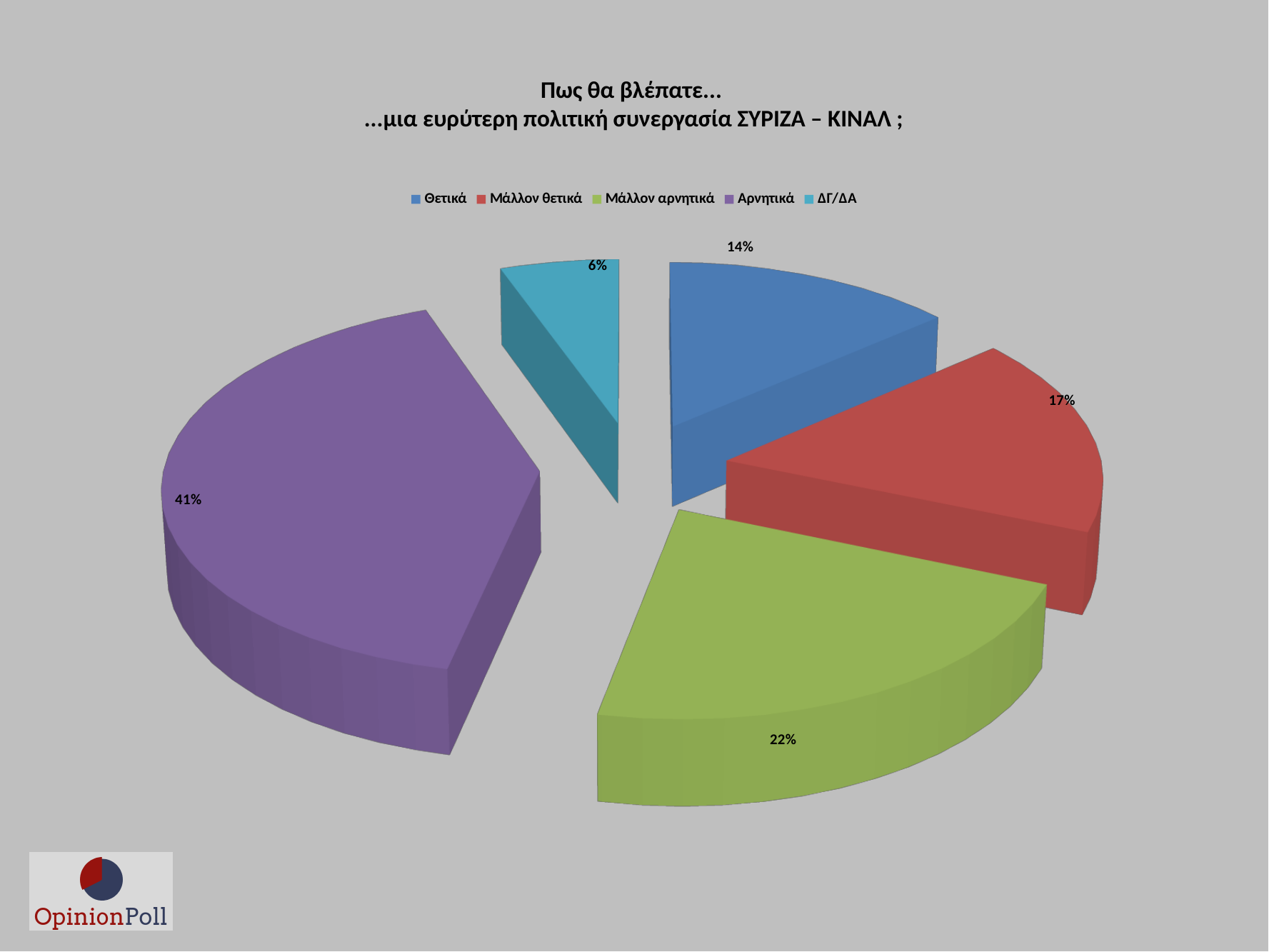
How many categories does the pie chart show? 5 What percentage of respondents answered Θετικά? 14% What percentage of respondents answered ΔΓ/ΔΑ? 6% What type of chart is shown on the slide? Pie chart What percentage of respondents answered Μάλλον θετικά? 17% What is the difference in percentage points between Αρνητικά and Μάλλον αρνητικά? 19 What percentage of respondents answered Μάλλον αρνητικά? 22% What colour is the slice for Αρνητικά? Purple Which response has the largest share of the pie? Αρνητικά What percentage of respondents answered Αρνητικά? 41% Which response has the smallest share of the pie? ΔΓ/ΔΑ Which is larger, the share for Θετικά or the share for Μάλλον θετικά? Μάλλον θετικά